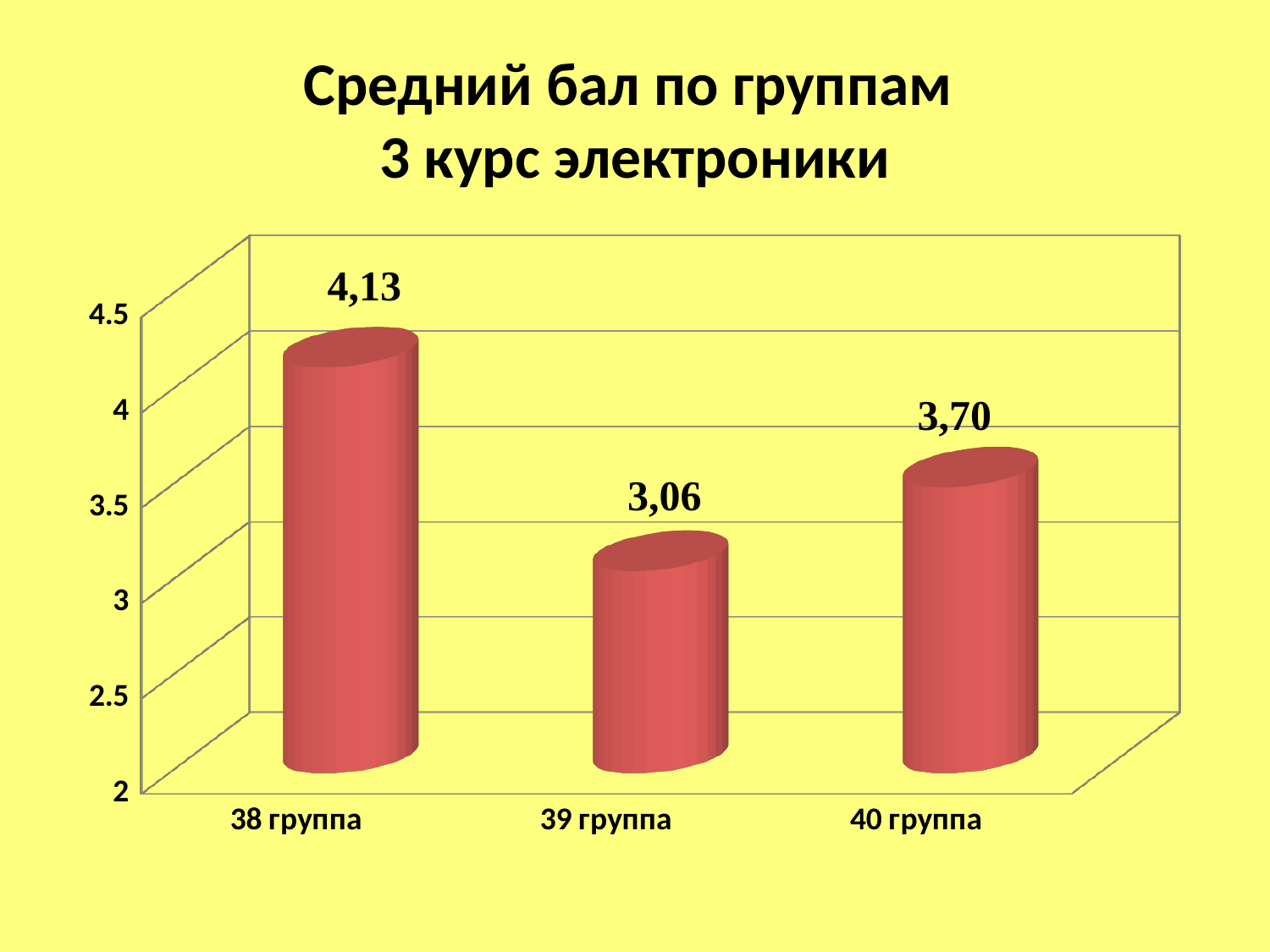
What is the average score for 40 группа? 3,70 What is the difference between the average scores of 40 группа and 39 группа? 0,64 Is the value for 38 группа greater or less than 4? greater What kind of chart is shown on the slide? bar chart What is the difference between the average scores of 38 группа and 39 группа? 1,07 What is the average score for 38 группа? 4,13 What is the average score for 39 группа? 3,06 Which has a higher average score, 39 группа or 40 группа? 40 группа How many groups are shown in the chart? 3 Which group has the lowest average score? 39 группа What is the title of the chart? Средний бал по группам 3 курс электроники Which group has the highest average score? 38 группа